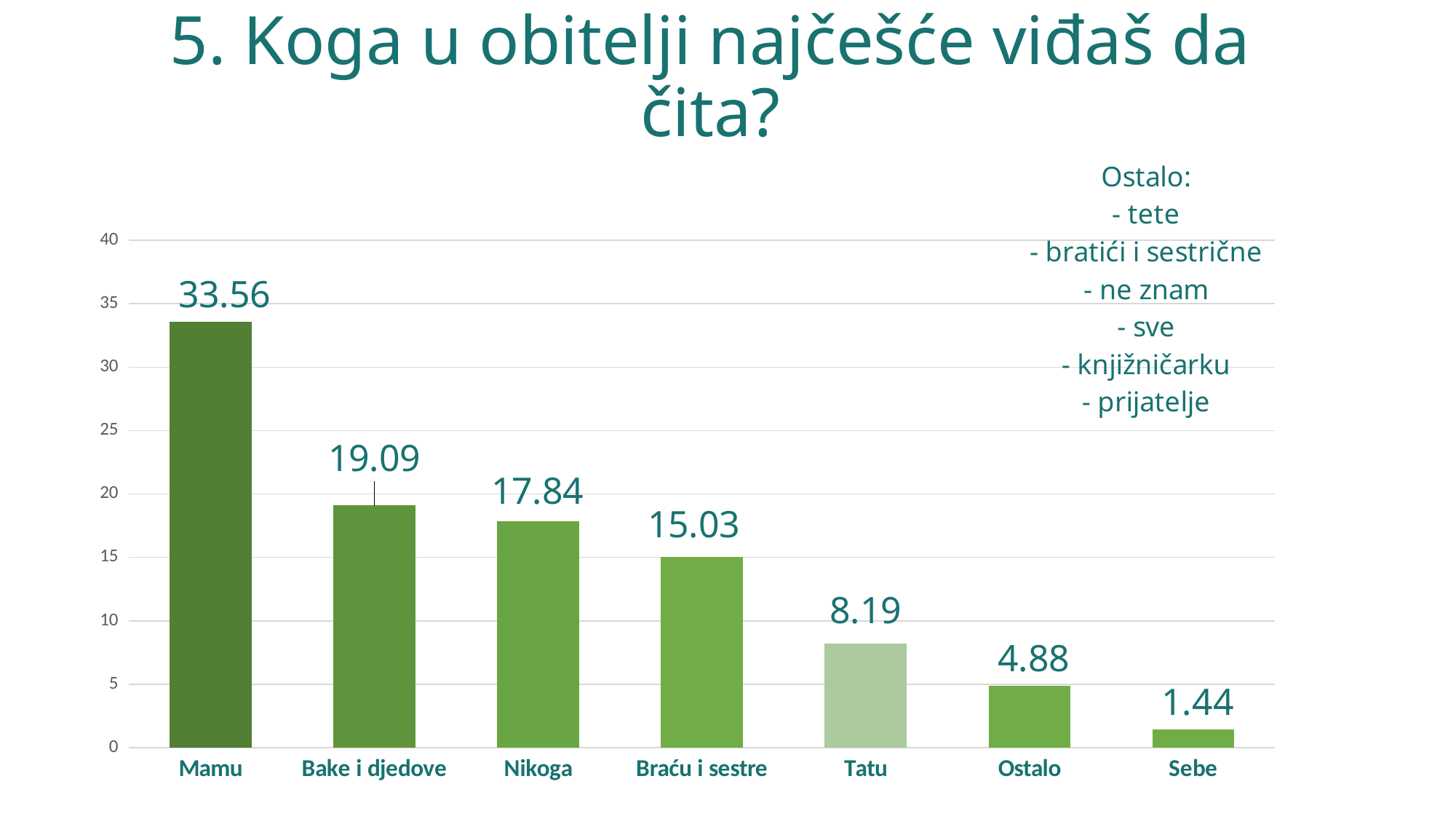
Which is larger, the value for Tatu or the value for Ostalo? Tatu Do the values rise or fall from left to right along the x axis? fall What is the difference between the values for Mamu and Bake i djedove? 14.47 What is the value for Bake i djedove? 19.09 What is the value for Tatu? 8.19 What is the value for Mamu? 33.56 Which category has the lowest value? Sebe What is the value for Sebe? 1.44 How many categories are shown on the x axis? 7 What is the difference between the values for Nikoga and Braću i sestre? 2.81 Which category has the highest value? Mamu What kind of chart is shown on the slide? bar chart